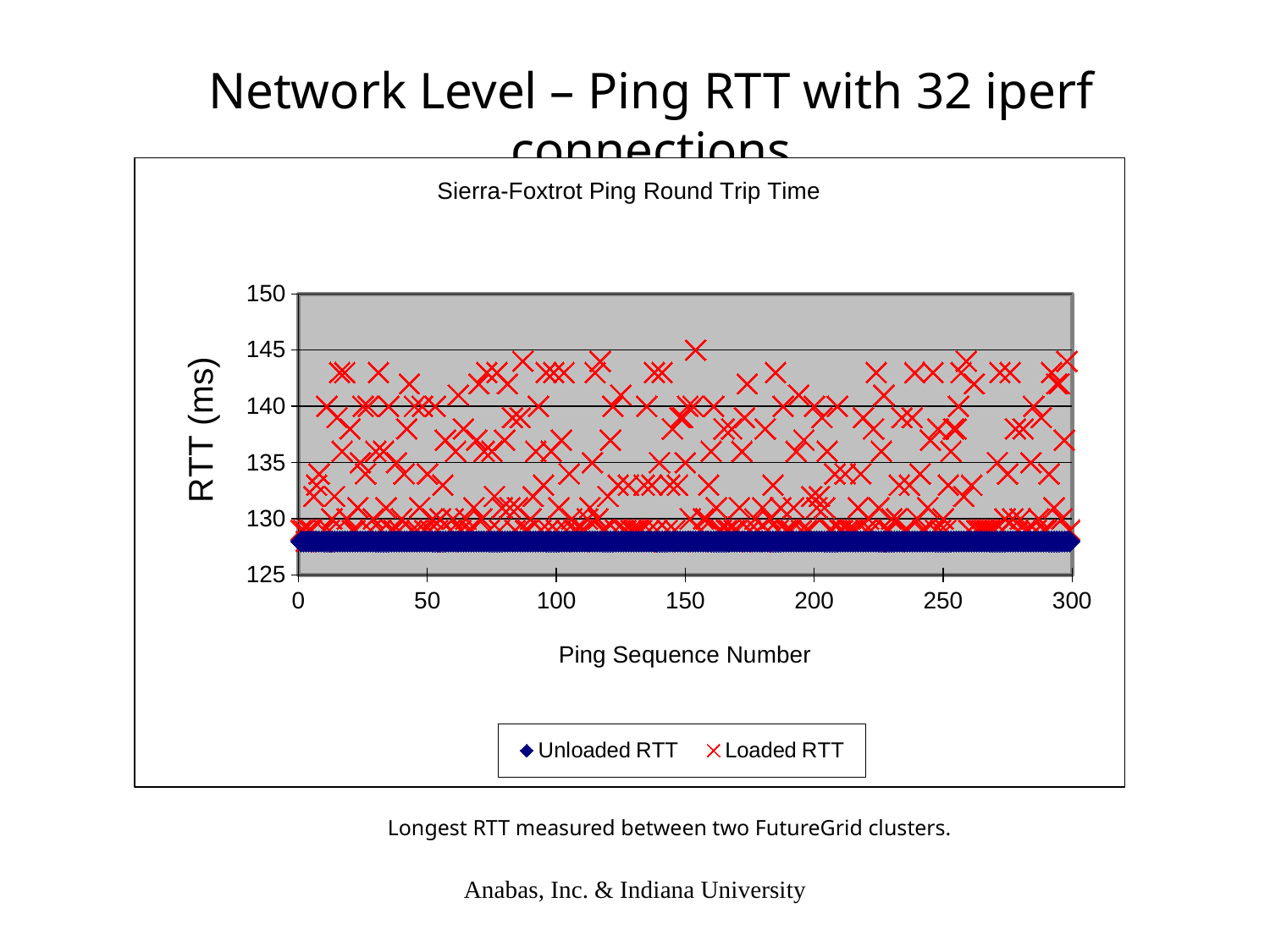
Which series generally has higher RTT values, Unloaded RTT or Loaded RTT? Loaded RTT Are the Unloaded RTT values greater or less than 130 ms? less How many series does the legend list? 2 Which series is plotted with red x markers? Loaded RTT What kind of chart is shown on the slide? scatter chart Do the Unloaded RTT values rise, fall, or stay flat as the ping sequence number increases? stay flat Which series shows the lowest RTT values on the chart? Unloaded RTT What is the title of the chart? Sierra-Foxtrot Ping Round Trip Time Is the highest Loaded RTT value greater or less than 150 ms? less Are the Unloaded RTT values greater or less than 125 ms? greater